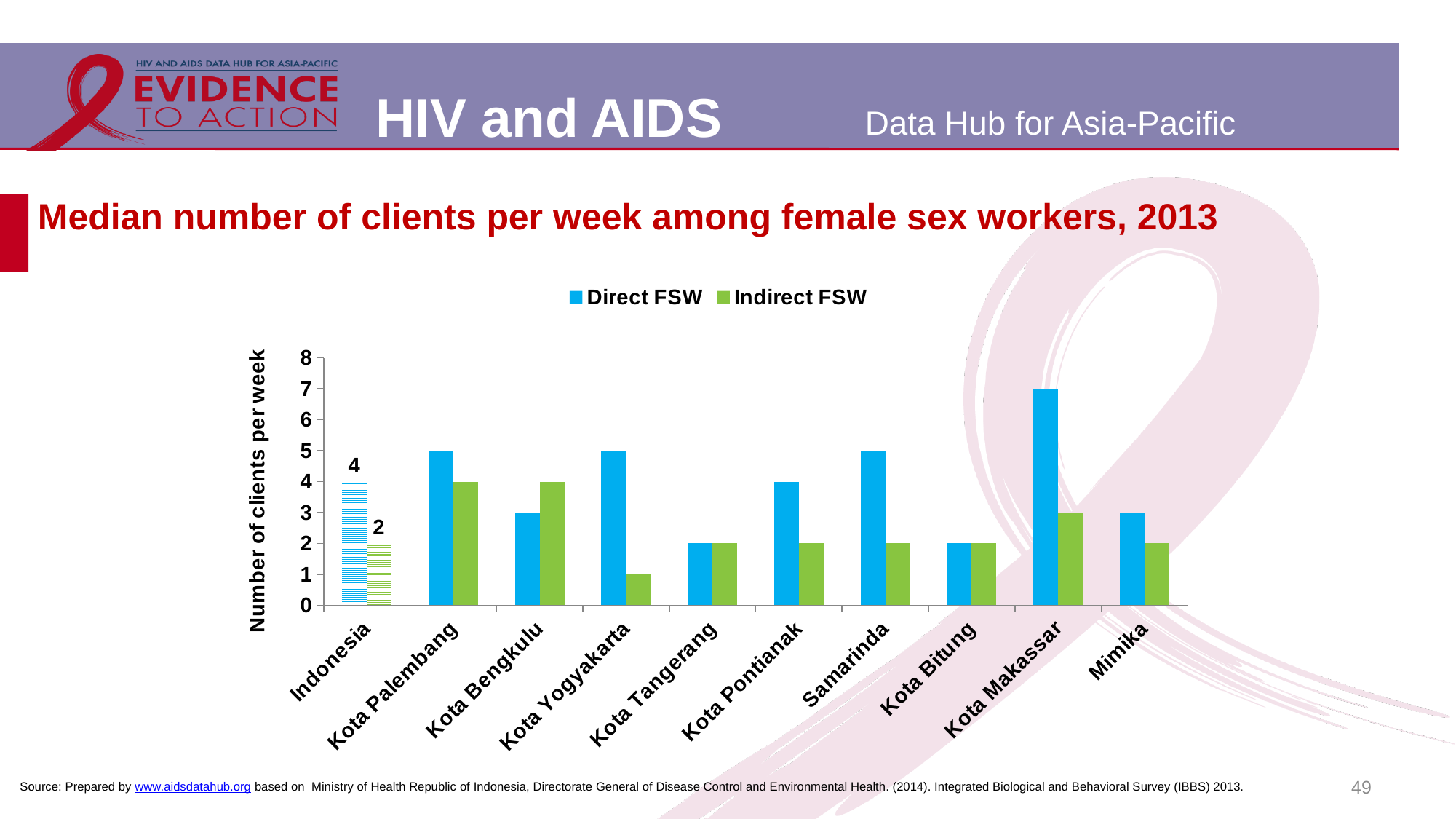
What is the median number of clients per week for Indirect FSW in Indonesia? 2 Which category has the highest value for Direct FSW? Kota Makassar What is the label of the y axis? Number of clients per week Is the value for Direct FSW in Kota Makassar greater or less than 6? greater Which category has the lowest value for Indirect FSW? Kota Yogyakarta What is the median number of clients per week for Direct FSW in Indonesia? 4 What kind of chart is shown on the slide? Bar chart What is the difference between the Direct FSW and Indirect FSW values for Indonesia? 2 Which is larger in Kota Bengkulu, the Direct FSW value or the Indirect FSW value? Indirect FSW How many categories are shown on the x axis? 10 What is the value for Direct FSW in Kota Makassar? 7 How many series does the legend list? 2